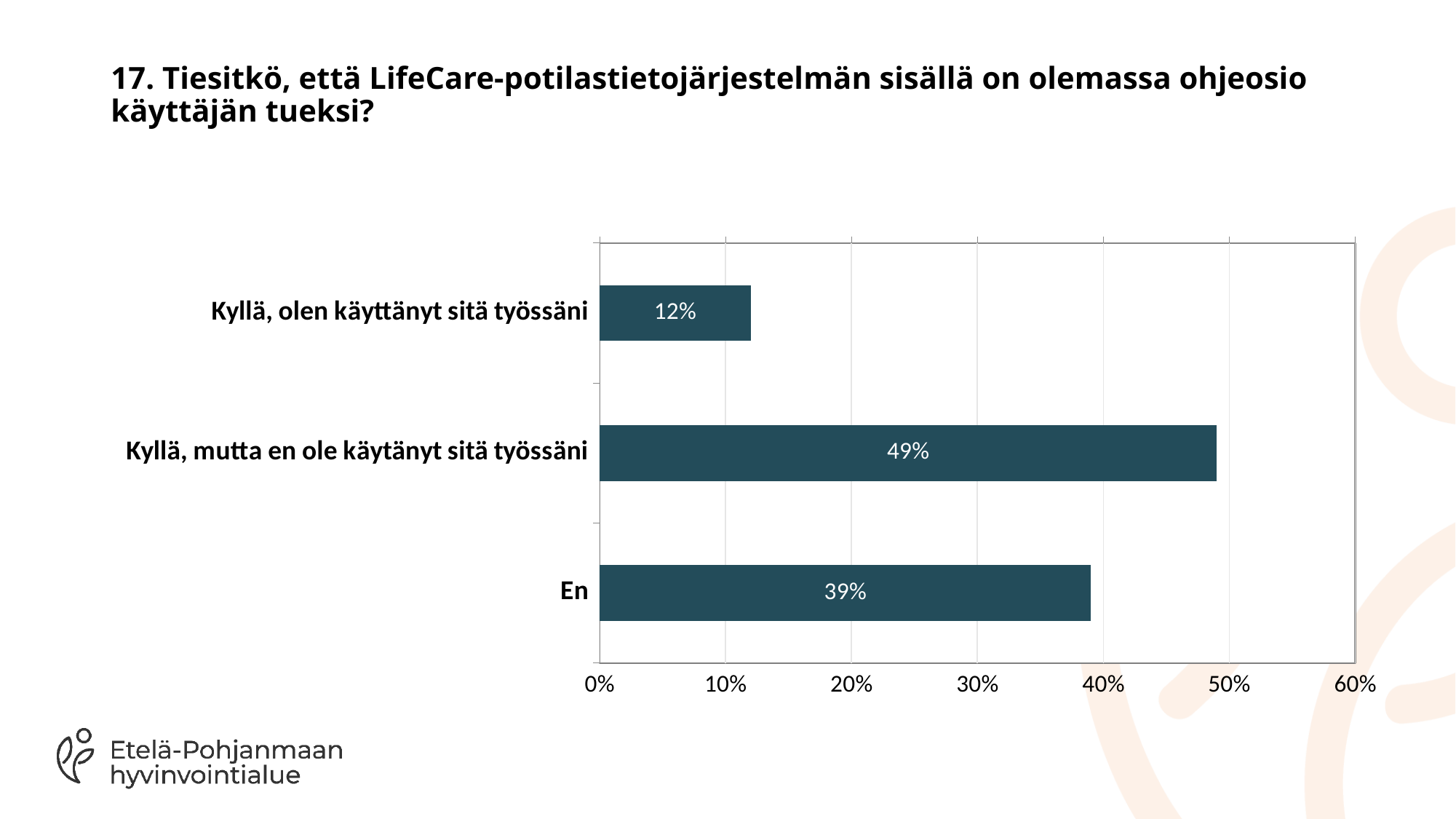
Is the value for "En" greater or less than 30%? greater Which is larger: the value for "En" or the value for "Kyllä, olen käyttänyt sitä työssäni"? En Which response category has the highest percentage? Kyllä, mutta en ole käytänyt sitä työssäni What is the maximum value shown on the horizontal axis? 60% Which response category has the lowest percentage? Kyllä, olen käyttänyt sitä työssäni What kind of chart is shown on the slide? Bar chart What percentage of respondents answered "Kyllä, mutta en ole käytänyt sitä työssäni"? 49% What percentage of respondents answered "Kyllä, olen käyttänyt sitä työssäni"? 12% How many response categories are shown in the chart? 3 What is the difference in percentage points between "En" and "Kyllä, olen käyttänyt sitä työssäni"? 27 percentage points What is the difference in percentage points between "Kyllä, mutta en ole käytänyt sitä työssäni" and "En"? 10 percentage points What percentage of respondents answered "En"? 39%